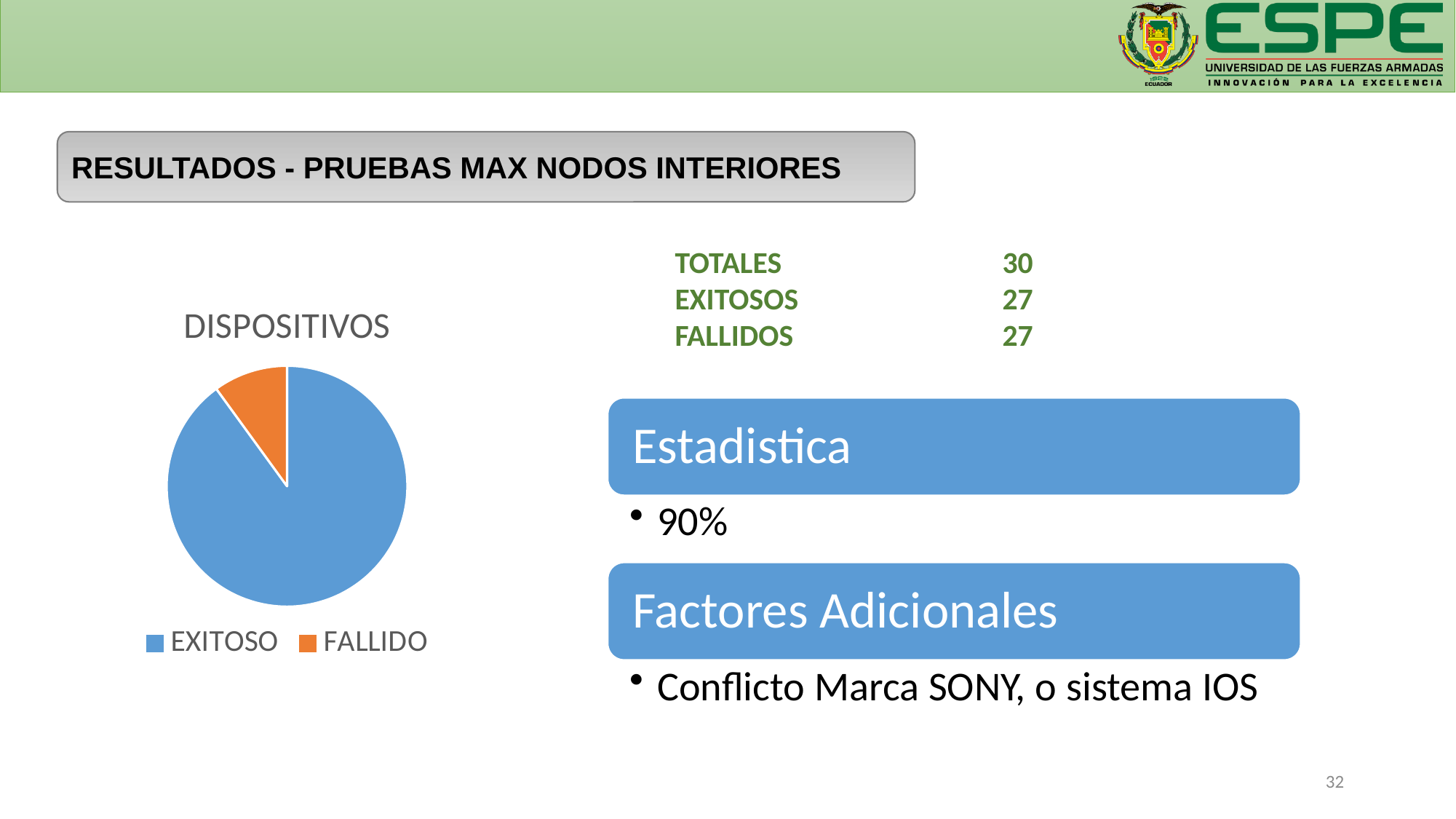
How many entries does the legend of the pie chart list? 2 What kind of chart is shown on the slide? pie chart What is the title of the pie chart? DISPOSITIVOS Which slice is larger in the pie chart, EXITOSO or FALLIDO? EXITOSO Which category has the largest slice in the pie chart? EXITOSO How many slices does the pie chart have? 2 Which category has the smallest slice in the pie chart? FALLIDO What colour is the EXITOSO slice in the pie chart? blue Which legend entry is shown in orange in the pie chart? FALLIDO